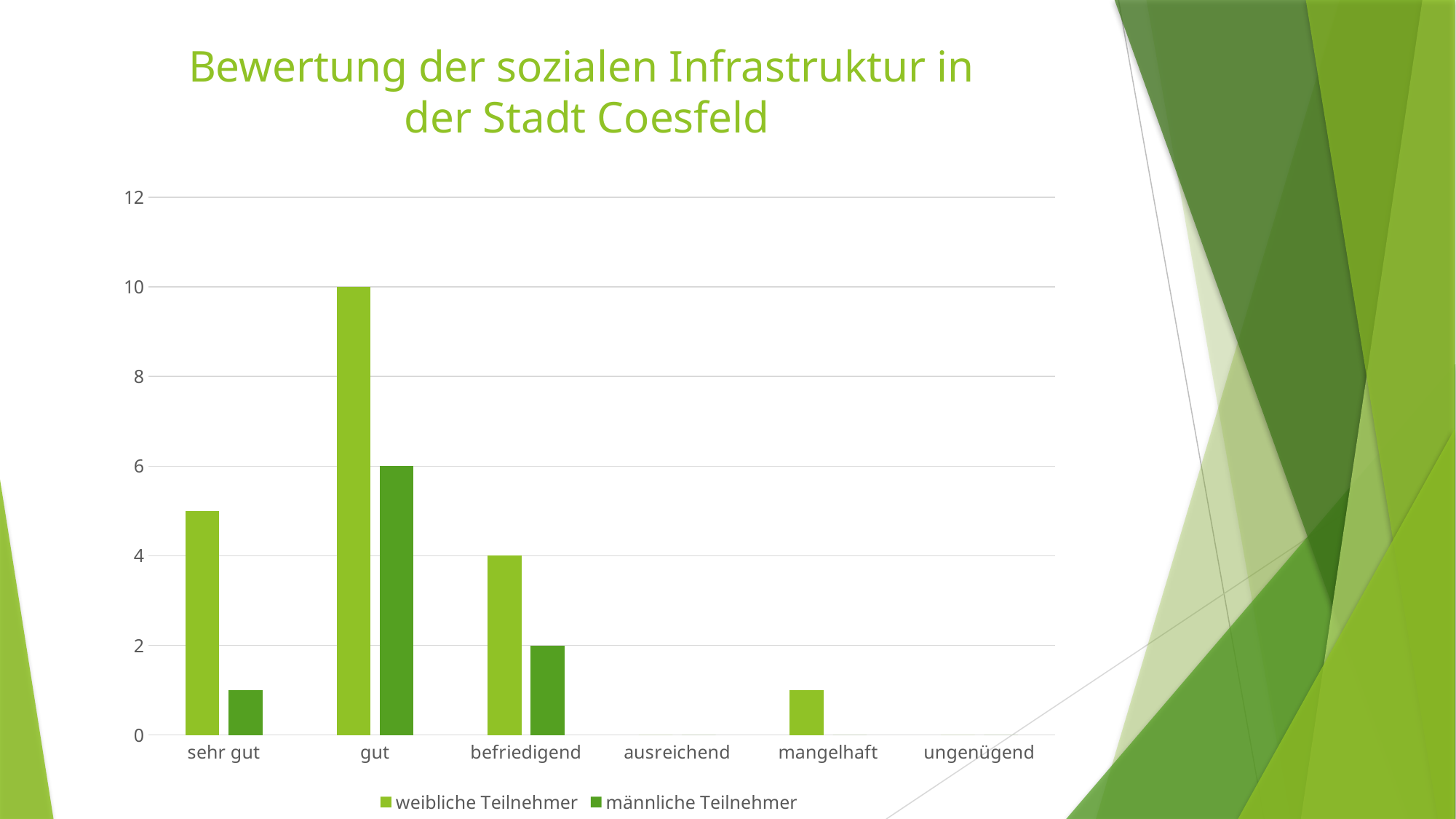
Which category has the highest value for weibliche Teilnehmer? gut Which category has the highest value for männliche Teilnehmer? gut Is the value for weibliche Teilnehmer in the category sehr gut greater or less than 4? greater How many categories are shown on the x axis? 6 What kind of chart is shown on the slide? bar chart How many series does the legend list? 2 Which is larger in the category sehr gut: weibliche Teilnehmer or männliche Teilnehmer? weibliche Teilnehmer What is the difference between weibliche Teilnehmer and männliche Teilnehmer in the category gut? 4 What is the value for männliche Teilnehmer in the category gut? 6 What is the value for männliche Teilnehmer in the category befriedigend? 2 What is the value for weibliche Teilnehmer in the category gut? 10 What is the value for weibliche Teilnehmer in the category befriedigend? 4